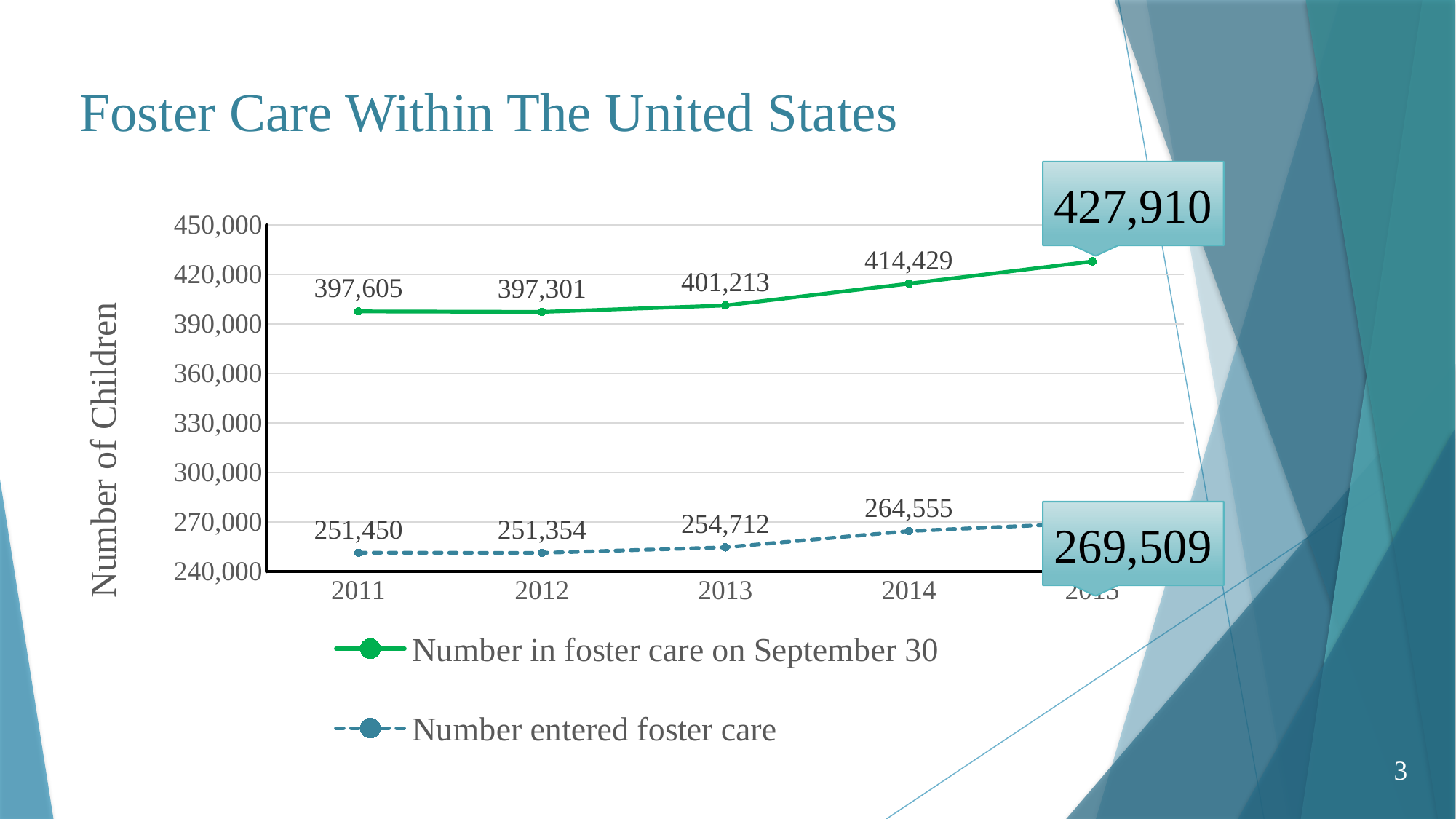
What was the number entered foster care in 2013? 254,712 What is the difference between the number in foster care on September 30 and the number entered foster care in 2014? 149,874 What kind of chart is shown on the slide? Line chart How many series does the legend list? 2 How many years are plotted along the x axis? 5 In which year was the number entered foster care highest? 2015 What was the number in foster care on September 30 in 2014? 414,429 What was the number in foster care on September 30 in 2011? 397,605 Does the number entered foster care generally rise or fall from 2011 to 2015? Rise What value does the callout show for the number entered foster care in the final year (2015)? 269,509 In which year was the number in foster care on September 30 lowest? 2012 What is the label of the y axis? Number of Children